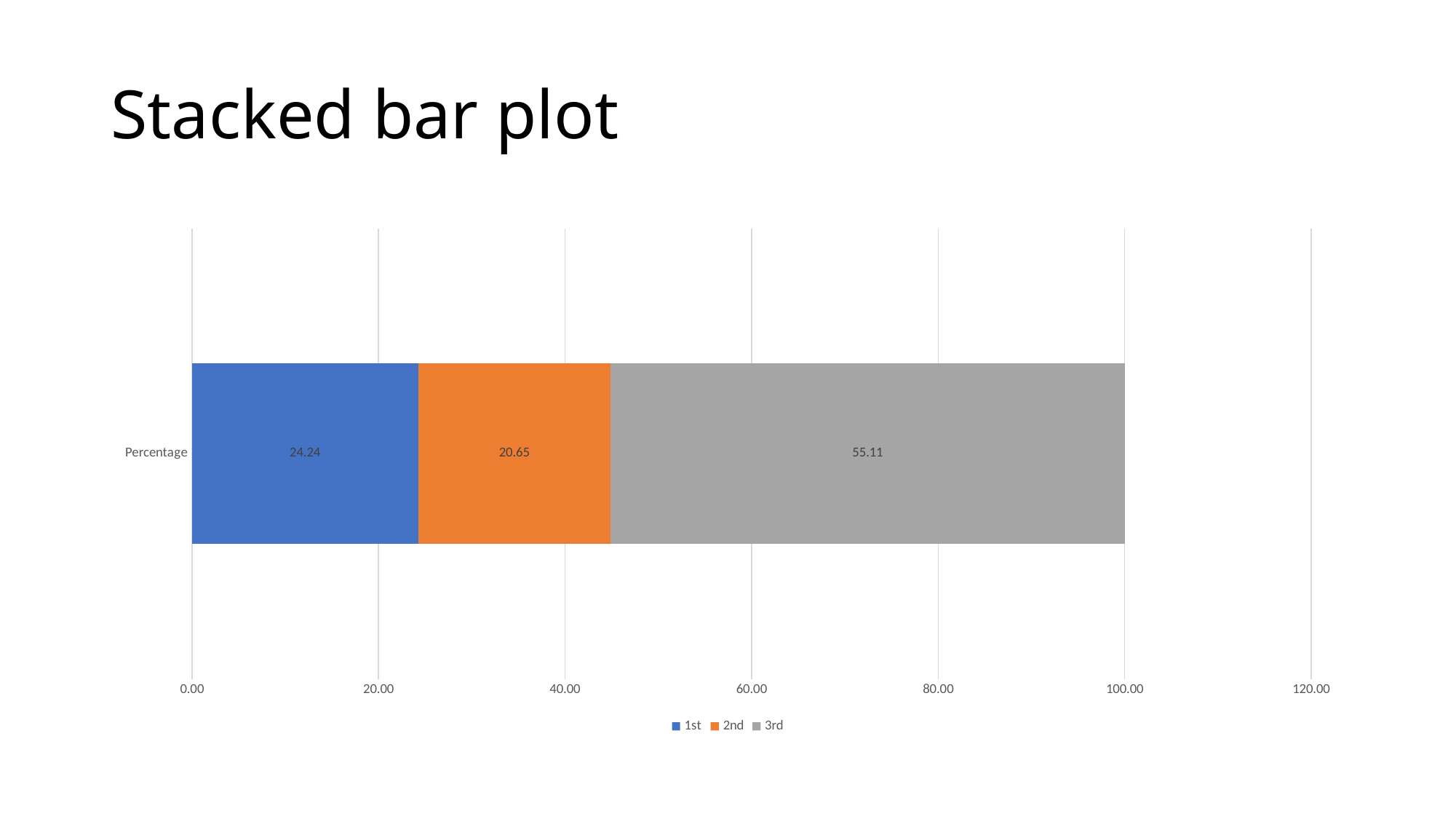
How many series does the legend list? 3 What is the difference between the 3rd and 1st series values? 30.87 What is the value of the 2nd series for Percentage? 20.65 What is the total of the stacked Percentage bar? 100.00 Which is larger, the 1st series value or the 2nd series value? 1st Which series has the largest value in the Percentage bar? 3rd What is the difference between the 1st and 2nd series values? 3.59 What colour represents the 3rd series? Grey What kind of chart is shown on the slide? Stacked bar chart What is the value of the 1st series for Percentage? 24.24 Which series has the smallest value in the Percentage bar? 2nd What is the value of the 3rd series for Percentage? 55.11